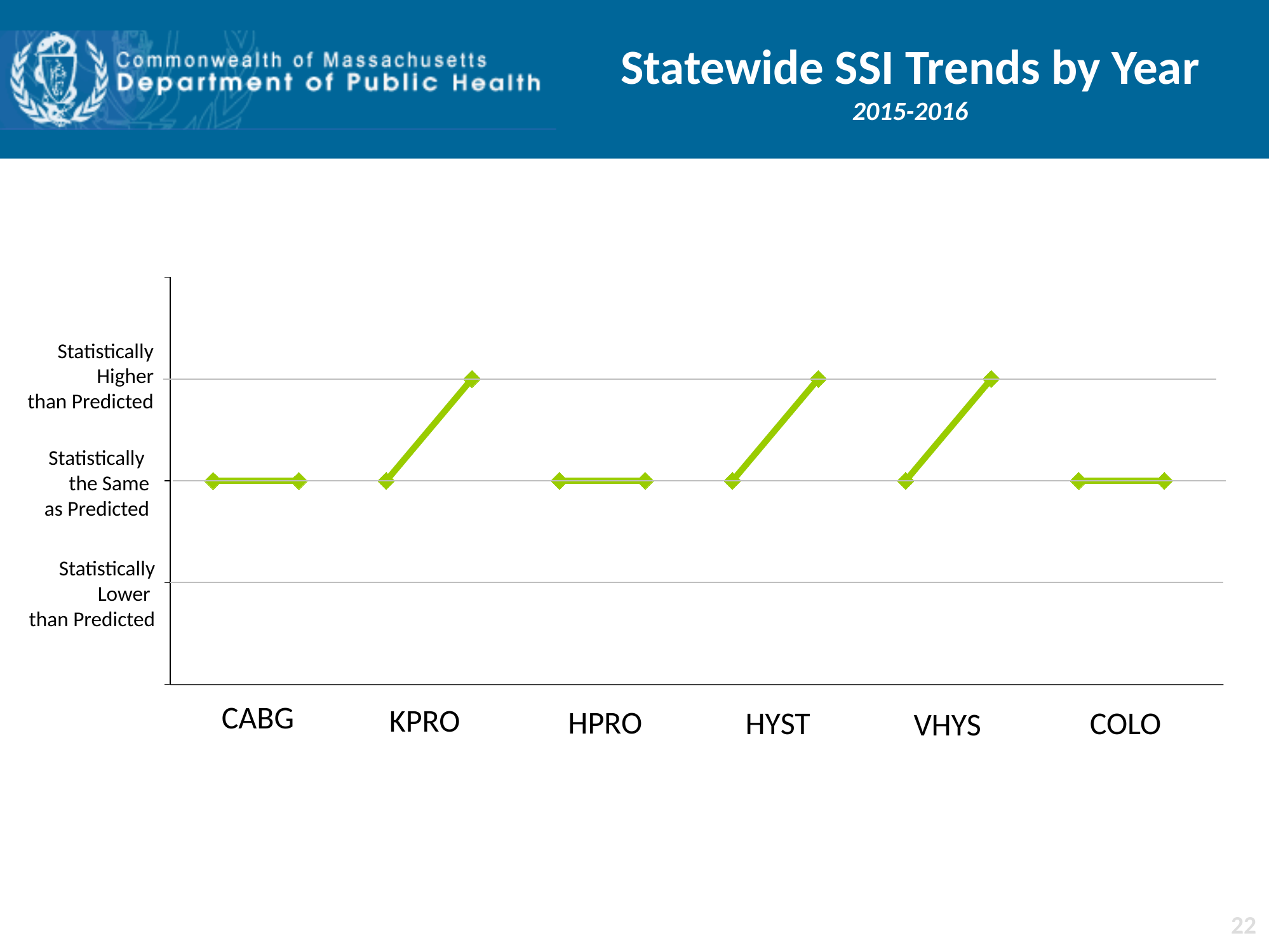
Does the line for HPRO rise, fall, or stay flat from its first point to its second point? stay flat Where does the second (right-hand) point for COLO land on the y axis? Statistically the Same as Predicted What is the title of the chart on the slide? Statewide SSI Trends by Year Which years does the chart subtitle say the trends cover? 2015-2016 What kind of chart is shown on the slide? line chart Where does the second (right-hand) point for VHYS land on the y axis? Statistically Higher than Predicted Where does the first (left-hand) point for HYST land on the y axis? Statistically the Same as Predicted Does the line for HYST rise, fall, or stay flat from its first point to its second point? rise Where does the second (right-hand) point for CABG land on the y axis? Statistically the Same as Predicted Where does the second (right-hand) point for KPRO land on the y axis? Statistically Higher than Predicted How many procedure categories are shown along the x axis? 6 Which procedures have a line that rises to Statistically Higher than Predicted? KPRO, HYST, VHYS